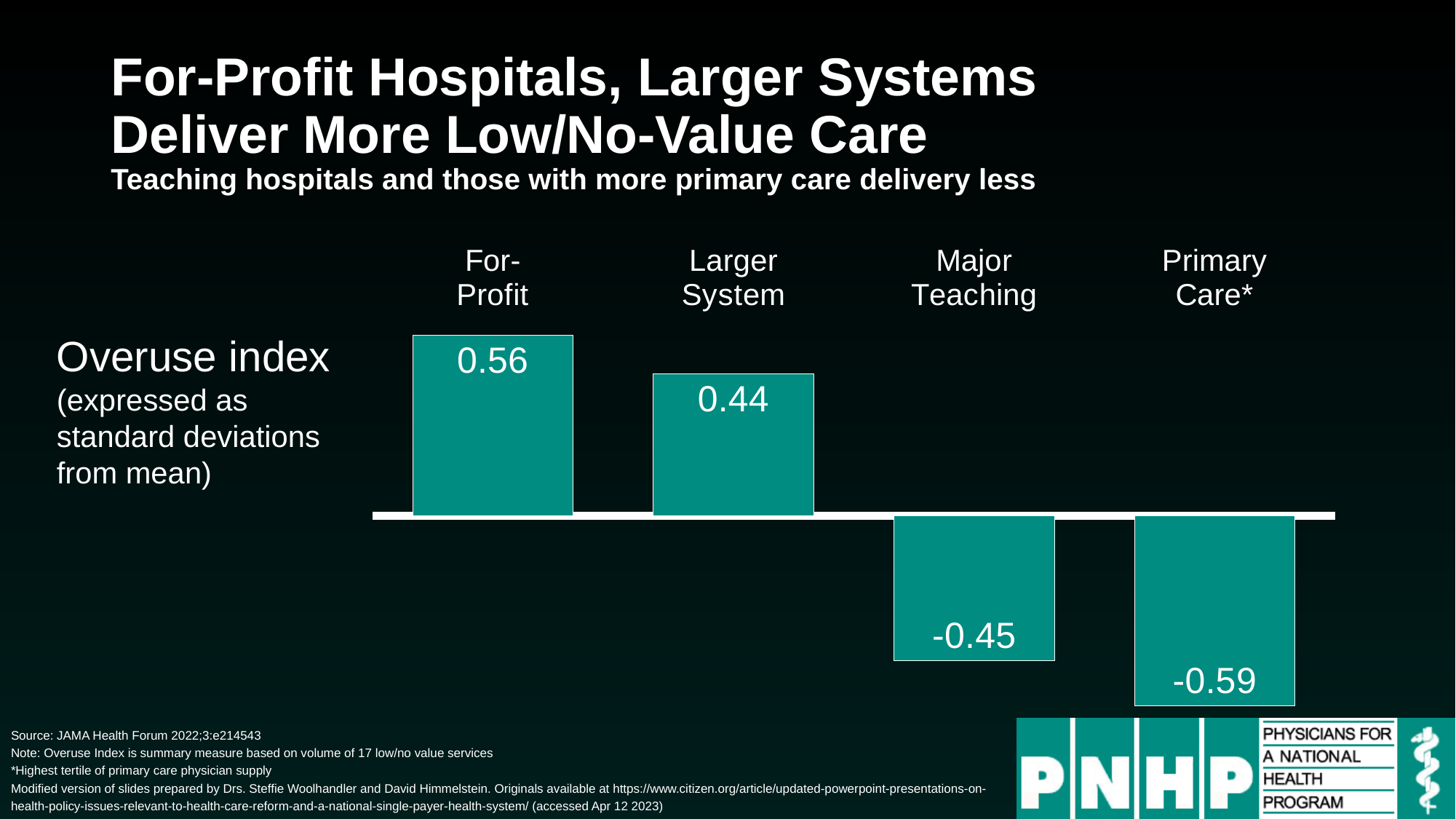
What is the difference between the overuse index for For-Profit and Larger System? 0.12 How many categories are shown in the chart? 4 Which has a higher overuse index, Larger System or Major Teaching? Larger System Which category has the lowest overuse index? Primary Care* Which category has the highest overuse index? For-Profit What is the overuse index value for Larger System? 0.44 What is the difference between the overuse index for Major Teaching and Primary Care*? 0.14 What is the overuse index value for Primary Care*? -0.59 How many categories have a negative overuse index? 2 What is the overuse index value for For-Profit hospitals? 0.56 What is the overuse index value for Major Teaching hospitals? -0.45 What kind of chart is shown on the slide? Bar chart